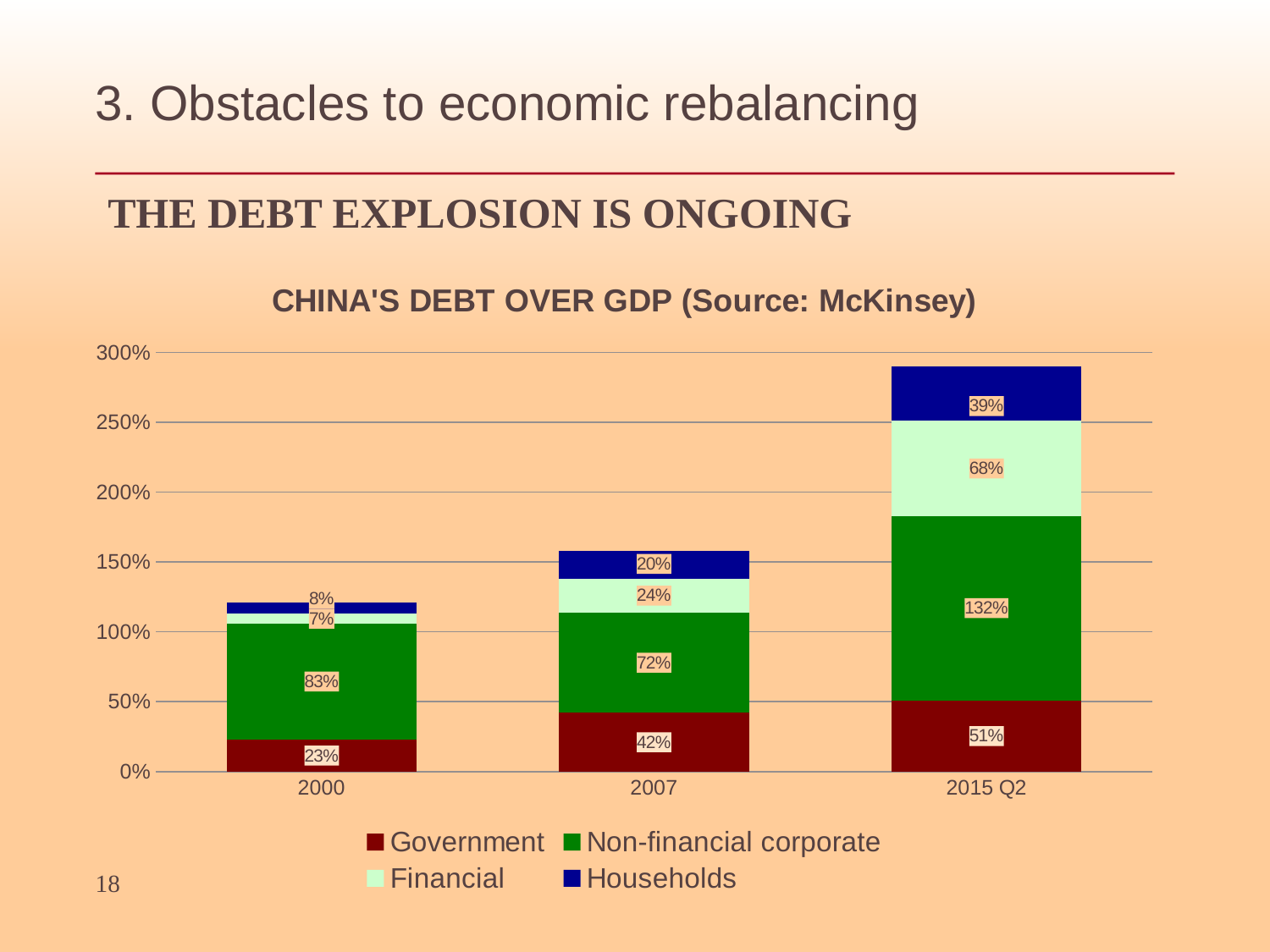
What is the Financial debt value for 2000? 7% What type of chart is shown on the slide? Stacked bar chart What is the Non-financial corporate debt value for 2015 Q2? 132% Which year has the lowest Households debt value? 2000 What is the difference between the Financial debt values for 2015 Q2 and 2007? 44% Does the total height of the bars rise or fall from 2000 to 2015 Q2? Rise Which is larger, the Non-financial corporate value for 2000 or for 2007? 2000 Which year has the highest Government debt value? 2015 Q2 What is the Government debt value for 2007? 42% What is the total debt over GDP for 2015 Q2 (sum of all four segments)? 290% How many series does the legend list? 4 What is the Households debt value for 2015 Q2? 39%